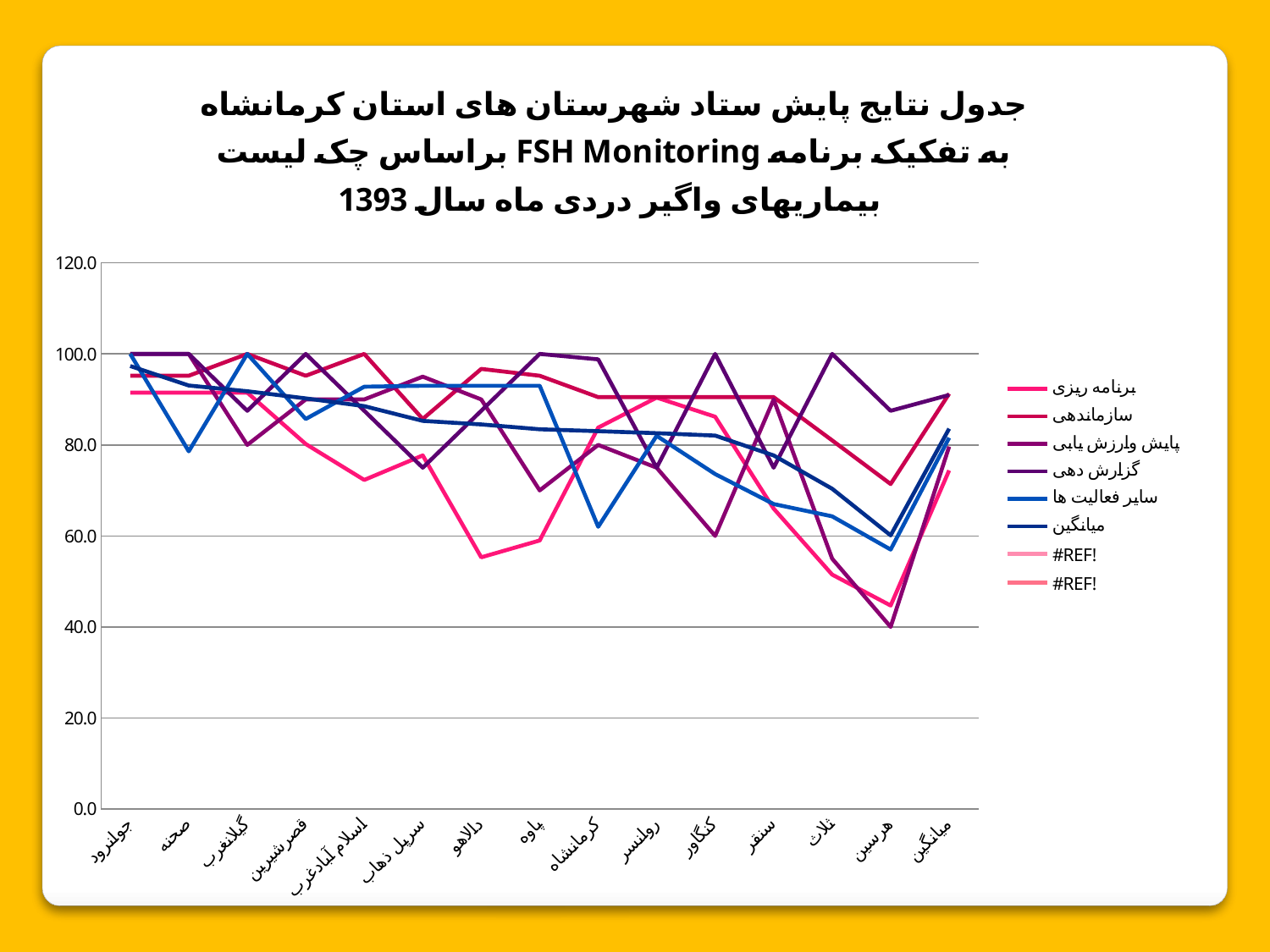
How many legend entries are labelled "#REF!"? 2 Is the value for گزارش دهی at هرسین greater or less than 60? greater Is the value for سازماندهی at هرسین greater or less than 80? less What year is mentioned in the chart title? 1393 Is the value for میانگین at جوانرود greater or less than 80? greater How many series does the chart's legend list? 8 What kind of chart is shown on the slide? line chart At هرسین, which series has the larger value: سازماندهی or برنامه ریزی? سازماندهی How many categories are shown along the x axis of the chart? 15 Does the میانگین series generally rise or fall from جوانرود to هرسین? fall